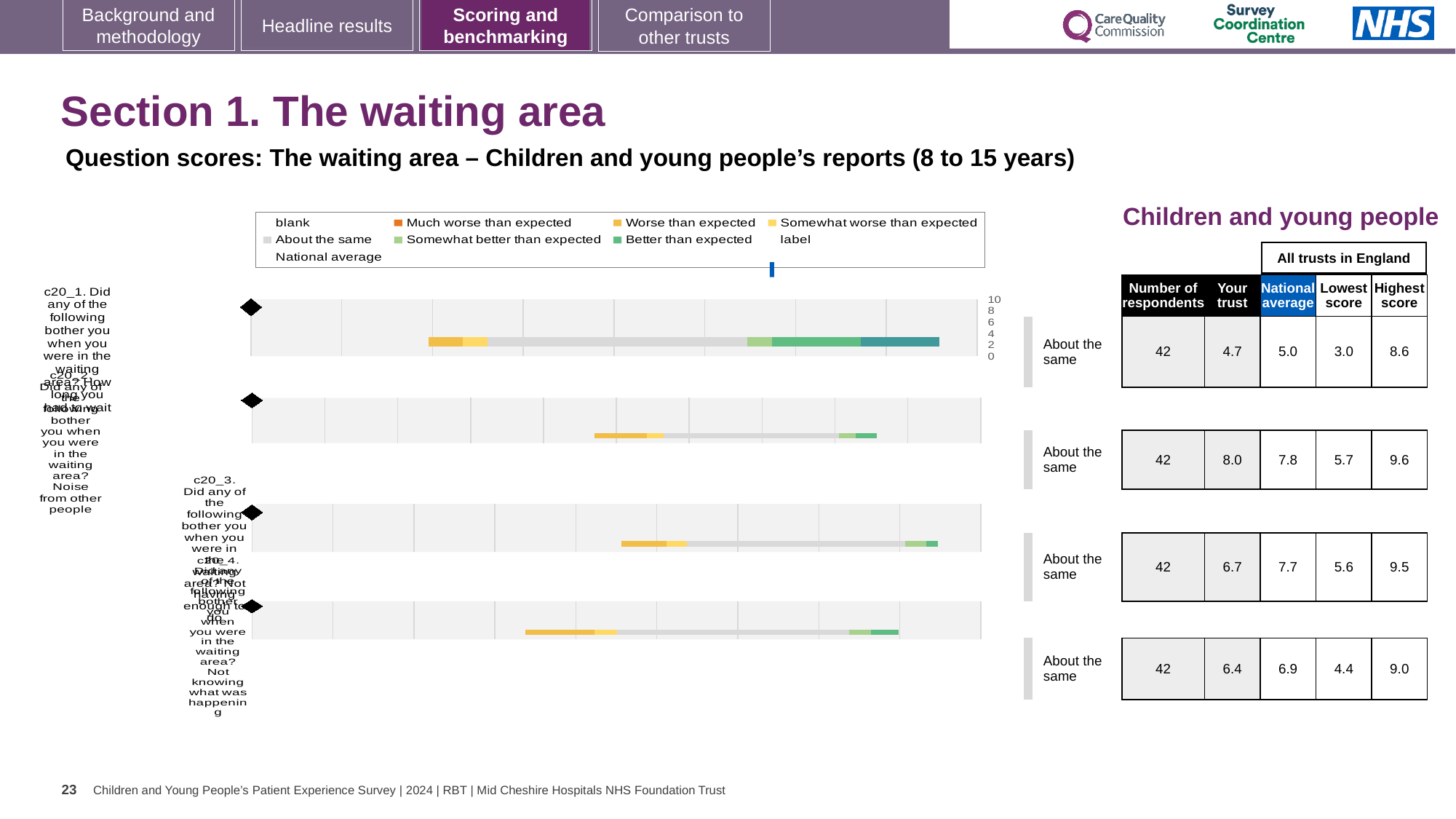
In the table beside the charts, what is the difference between the highest score and the lowest score for the first question (c20_1)? 5.6 In the table beside the charts, what is the 'Your trust' score for the first question (c20_1)? 4.7 What kind of chart is used to show the question scores on this slide? bar chart In the table beside the charts, which question has the highest 'Your trust' score? c20_2 What benchmark category is printed to the right of the fourth bar chart (c20_4)? About the same Which legend entry is shown in orange? Much worse than expected In the table beside the charts, what is the national average for the third question (c20_3)? 7.7 In the table beside the charts, how many respondents are listed for the fourth question (c20_4)? 42 Which legend entry is shown in light grey? About the same How many question bar charts are shown on the slide? 4 In the table beside the charts, what is the 'Your trust' score for the second question (c20_2)? 8.0 What benchmark category is printed to the right of the first bar chart (c20_1)? About the same